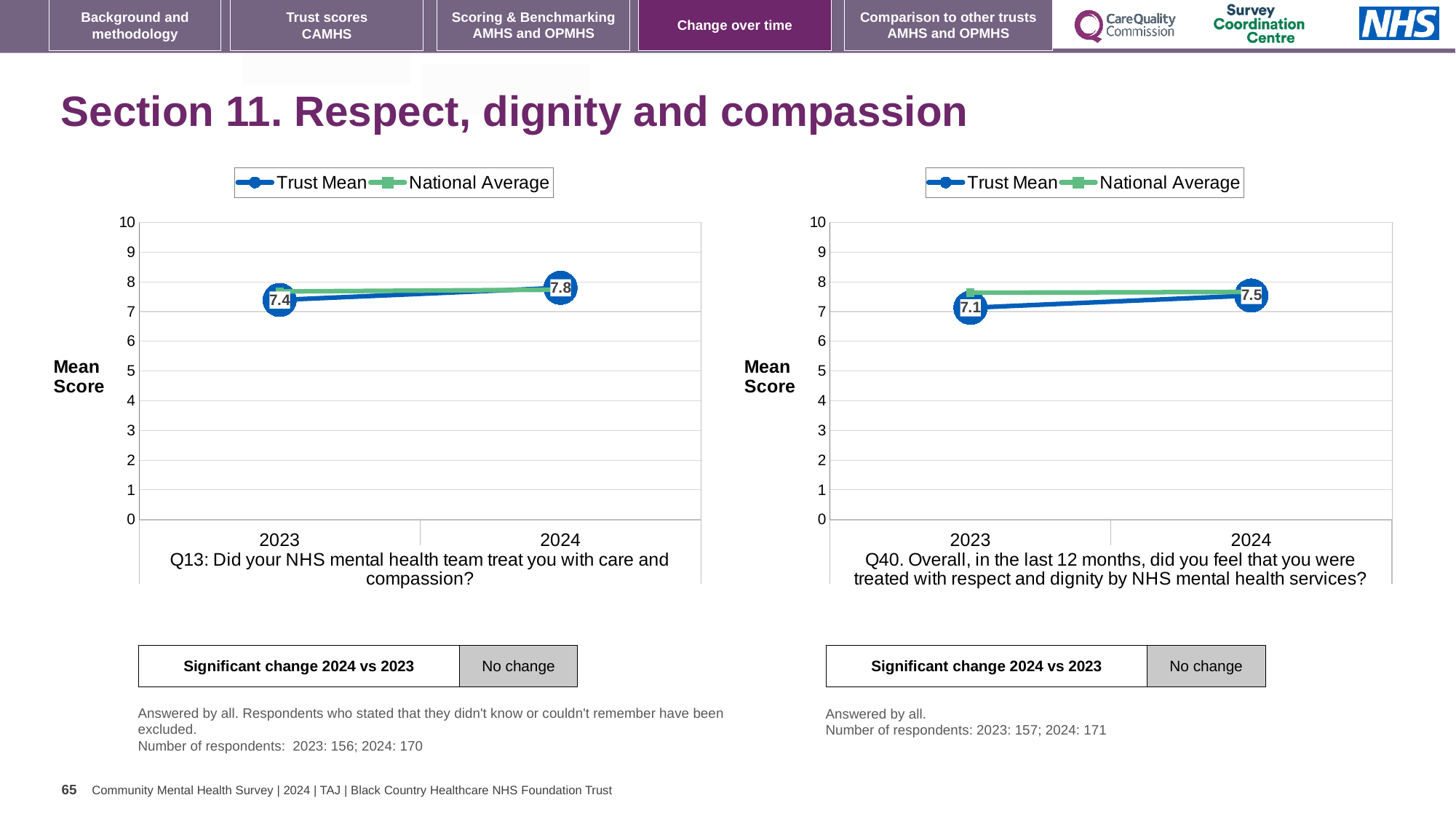
In the right chart (Q40), is the National Average for 2023 greater or less than 7? greater In the right chart (Q40), does the Trust Mean rise or fall from 2023 to 2024? rise In the right chart (Q40), what is the Trust Mean score for 2023? 7.1 How many years are shown on the x axis of the left chart (Q13)? 2 In the left chart (Q13), by how much did the Trust Mean change from 2023 to 2024? 0.4 How many series does the legend of the right chart (Q40) list? 2 In the right chart (Q40), what is the Trust Mean score for 2024? 7.5 In the left chart (Q13), what is the Trust Mean score for 2024? 7.8 In the left chart (Q13), what is the Trust Mean score for 2023? 7.4 In the right chart (Q40), what is the difference between the Trust Mean for 2024 and 2023? 0.4 In the right chart (Q40), which is higher for 2023: the Trust Mean or the National Average? National Average What type of chart is used on the left of the slide (Q13)? line chart